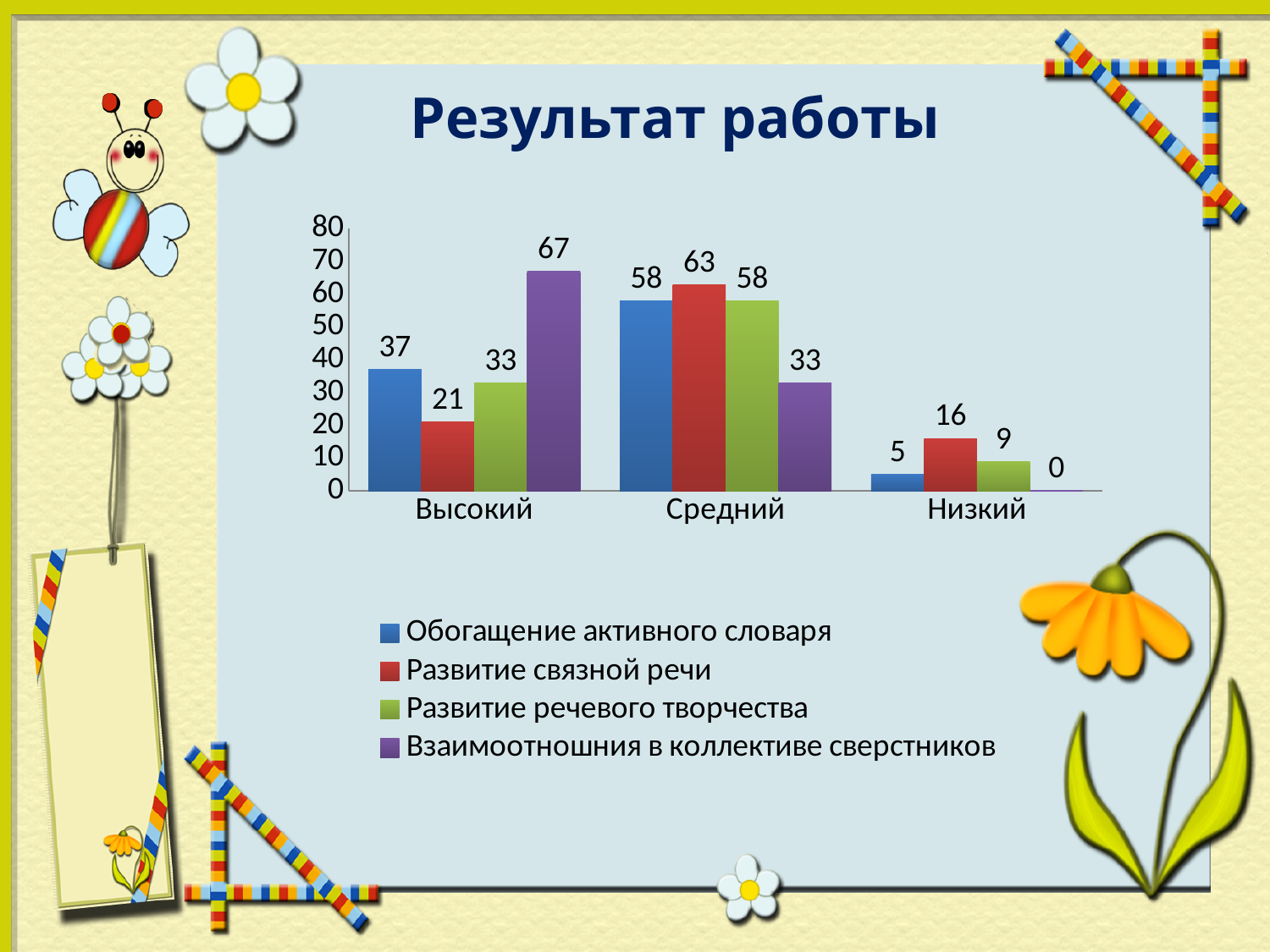
Which series has the lowest value in the Низкий category? Взаимоотношния в коллективе сверстников What is the value for Обогащение активного словаря in the Высокий category? 37 Which series has the highest value in the Высокий category? Взаимоотношния в коллективе сверстников What kind of chart is shown on the slide? bar chart Which is larger in the Высокий category: Развитие речевого творчества or Развитие связной речи? Развитие речевого творчества Is the value for Взаимоотношния в коллективе сверстников in the Высокий category greater or less than 60? greater How many series does the legend list? 4 What is the title of the slide? Результат работы What is the value for Взаимоотношния в коллективе сверстников in the Средний category? 33 What is the difference between the Развитие связной речи value and the Обогащение активного словаря value in the Средний category? 5 What is the value for Развитие связной речи in the Низкий category? 16 How many categories are shown on the x axis? 3